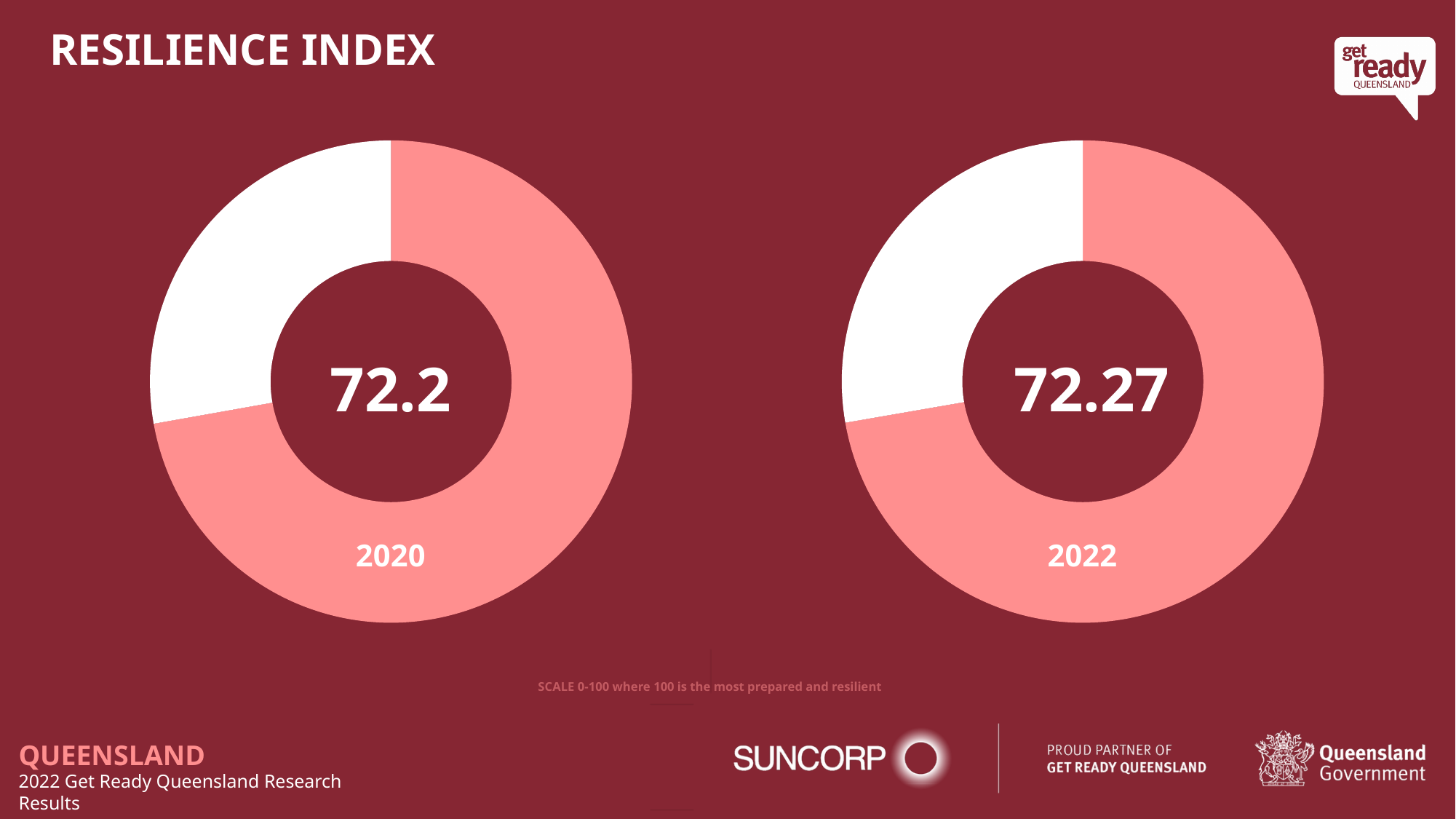
What is the Resilience Index value shown in the 2022 donut chart? 72.27 What is the difference between the 2022 and 2020 Resilience Index values? 0.07 What is the title of the slide containing the two donut charts? RESILIENCE INDEX According to the note below the charts, what scale is the Resilience Index measured on? 0-100 Which year is labelled on the left donut chart? 2020 How many donut charts are shown on the slide? 2 What kind of chart is used to display the Resilience Index for each year? Donut chart What is the Resilience Index value shown in the 2020 donut chart? 72.2 Is the 2020 Resilience Index value greater or less than 50? greater Did the Resilience Index rise or fall from 2020 to 2022? Rise Which year has the higher Resilience Index value, 2020 or 2022? 2022 Which year is labelled on the right donut chart? 2022